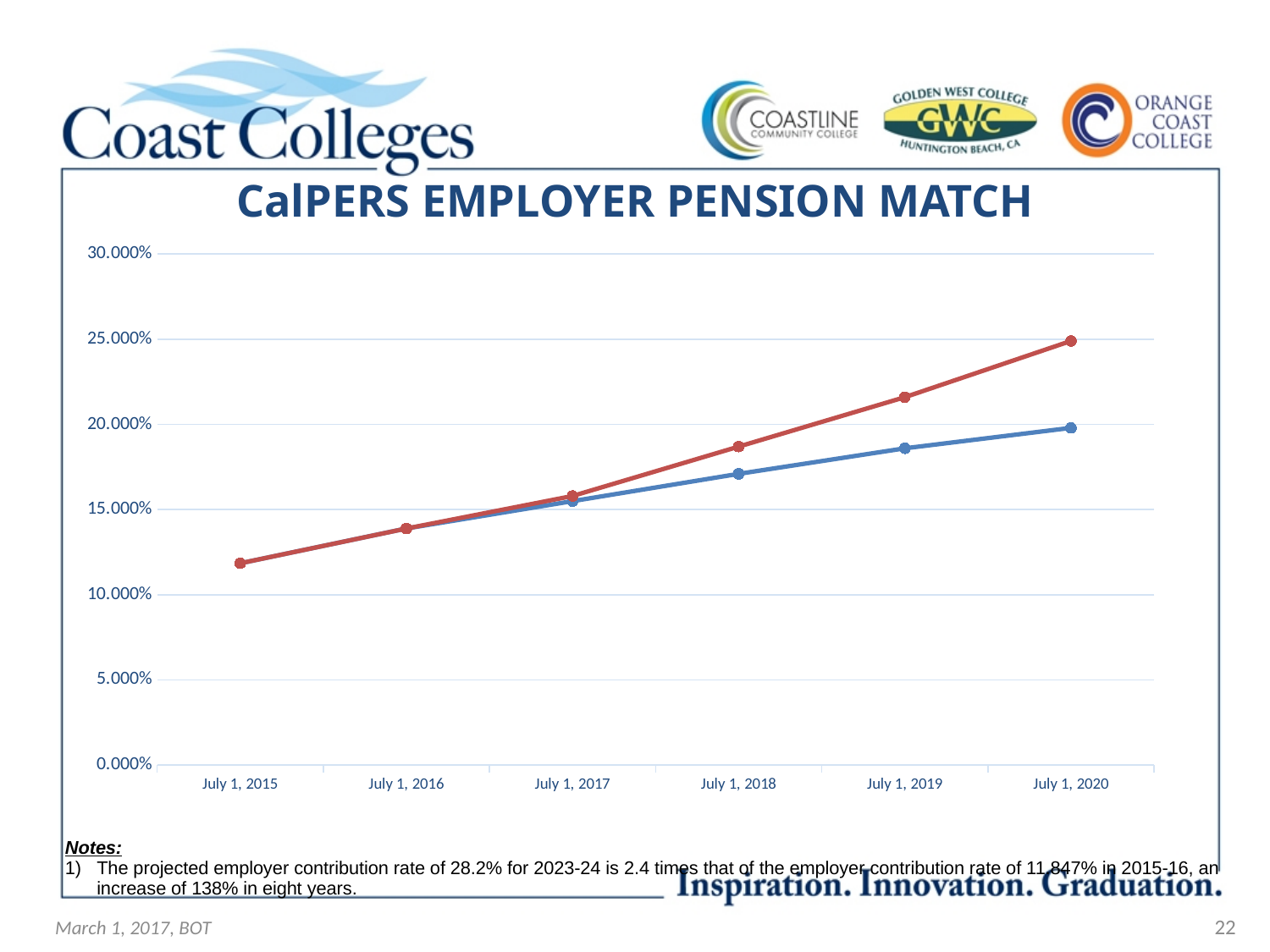
At which date does the blue line have its lowest value? July 1, 2015 What kind of chart is shown on the slide? line chart Is the value of the red line at July 1, 2019 greater or less than 20.000%? greater Do the values of the red line rise or fall from July 1, 2015 to July 1, 2020? rise At July 1, 2020, which line has the higher value, the red line or the blue line? the red line Is the value of the red line at July 1, 2020 greater or less than 20.000%? greater At which date does the red line reach its highest value? July 1, 2020 How many lines are plotted on the chart? 2 Is the value of the red line at July 1, 2015 greater or less than 15.000%? less What is the title of the chart? CalPERS EMPLOYER PENSION MATCH How many dates are shown along the x axis of the chart? 6